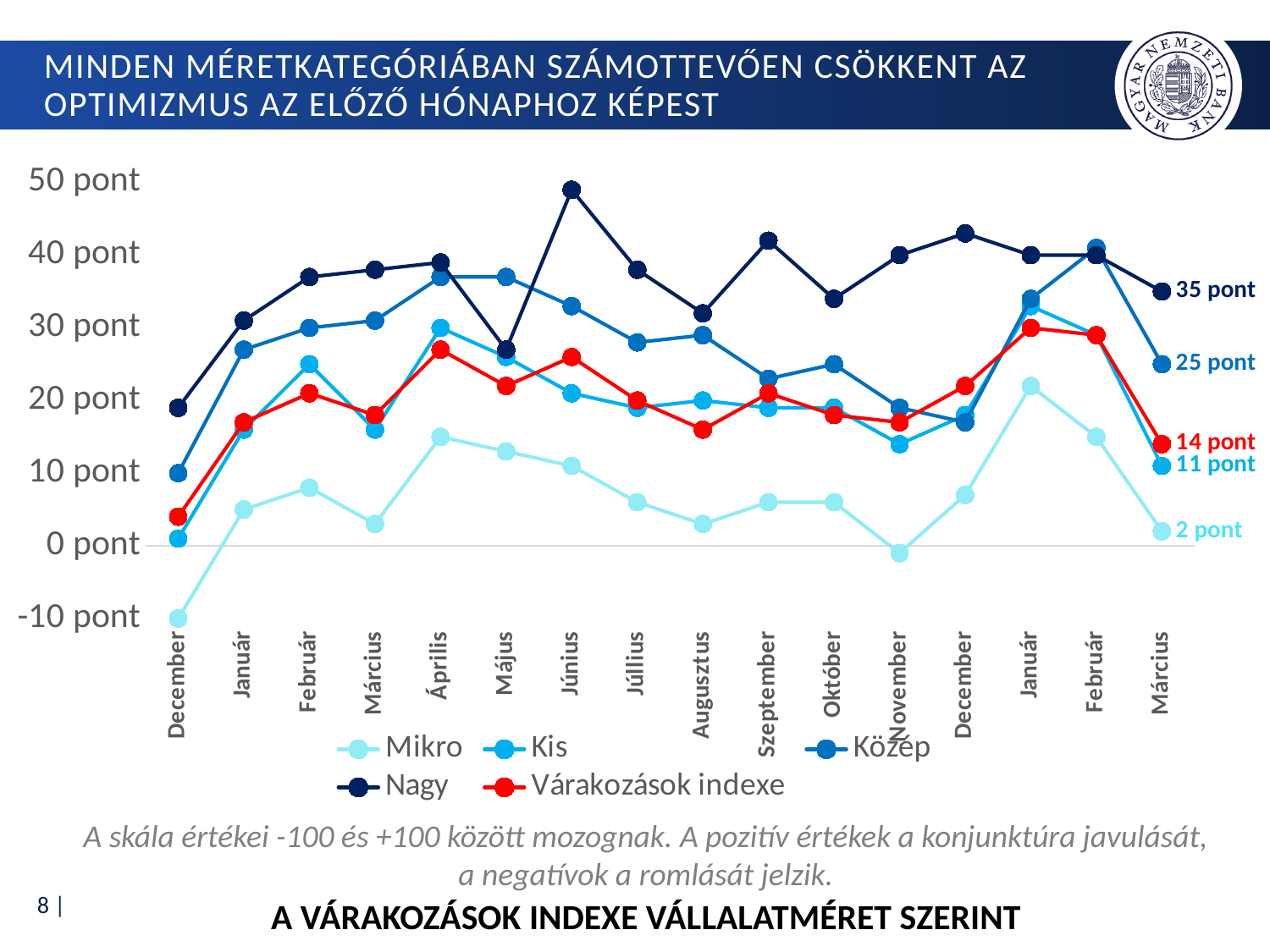
What is the value of the Közép series at the final Március point? 25 pont What kind of chart is shown on the slide? line chart How many series does the legend list? 5 What is the value of the Nagy series at the final Március point? 35 pont What is the value of the Mikro series at the final Március point? 2 pont Which series has the lowest value at the final Március point? Mikro Does the Nagy series rise or fall from Február to the final Március? fall Is the value of the Nagy series in Június greater or less than 40 pont? greater What is the difference between the Nagy and Mikro values at the final Március point? 33 pont At the final Március point, which is larger: the Kis value or the Mikro value? Kis Which series has the highest value at the final Március point? Nagy What is the value of the Várakozások indexe series at the final Március point? 14 pont